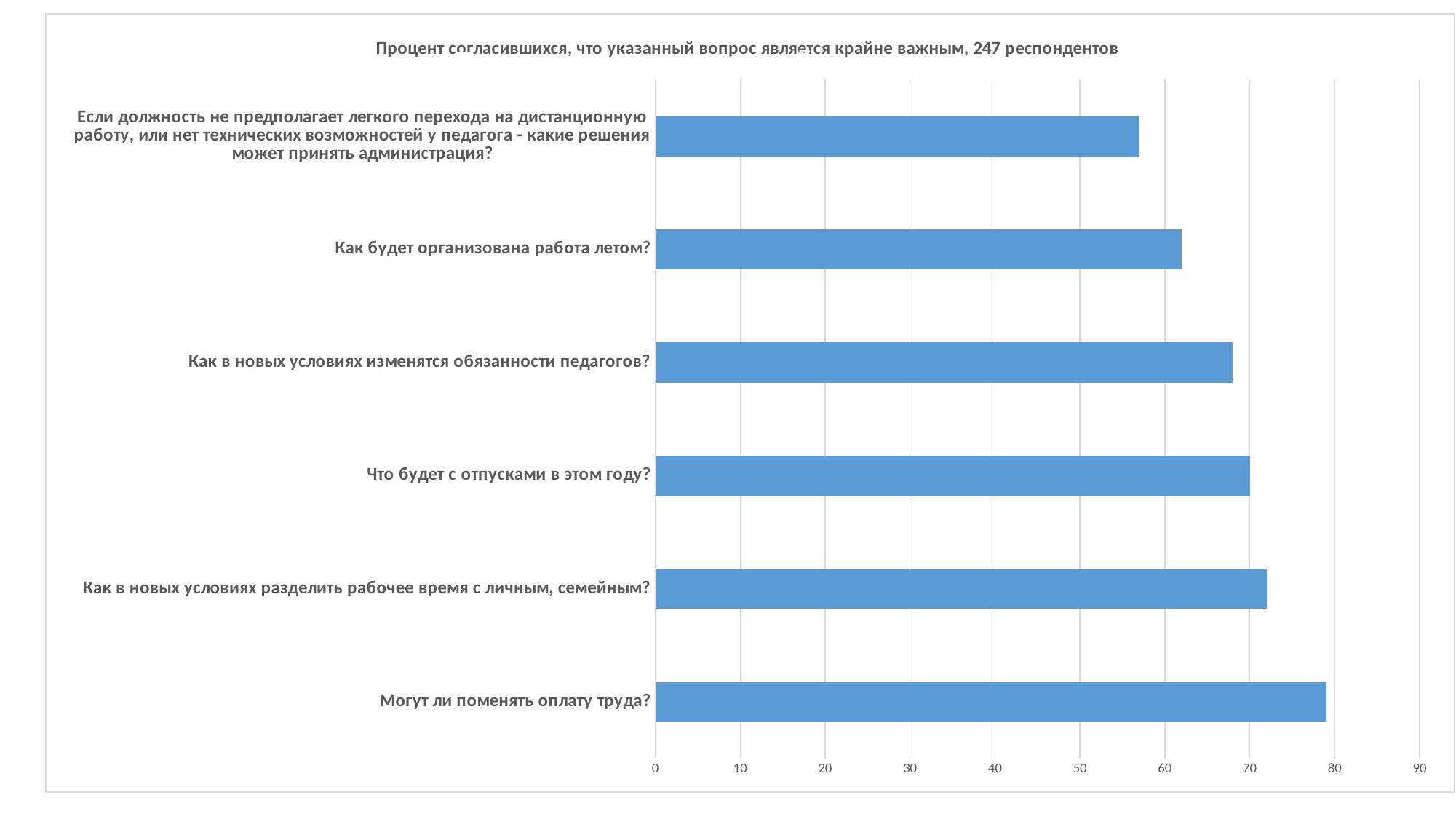
Is the value for "Как в новых условиях разделить рабочее время с личным, семейным?" greater or less than 80? less Which is larger: the value for "Могут ли поменять оплату труда?" or for "Что будет с отпусками в этом году?"? Могут ли поменять оплату труда? Which category has the highest value in the chart? Могут ли поменять оплату труда? How many respondents does the chart title say took part in the survey? 247 Is the value for "Как в новых условиях изменятся обязанности педагогов?" greater or less than 60? greater Which is larger: the value for "Как будет организована работа летом?" or for "Как в новых условиях изменятся обязанности педагогов?"? Как в новых условиях изменятся обязанности педагогов? Is the value for "Могут ли поменять оплату труда?" greater or less than 70? greater Which category has the lowest value in the chart? Если должность не предполагает легкого перехода на дистанционную работу, или нет технических возможностей у педагога - какие решения может принять администрация? What kind of chart is shown on the slide? Bar chart How many categories (questions) are plotted in the chart? 6